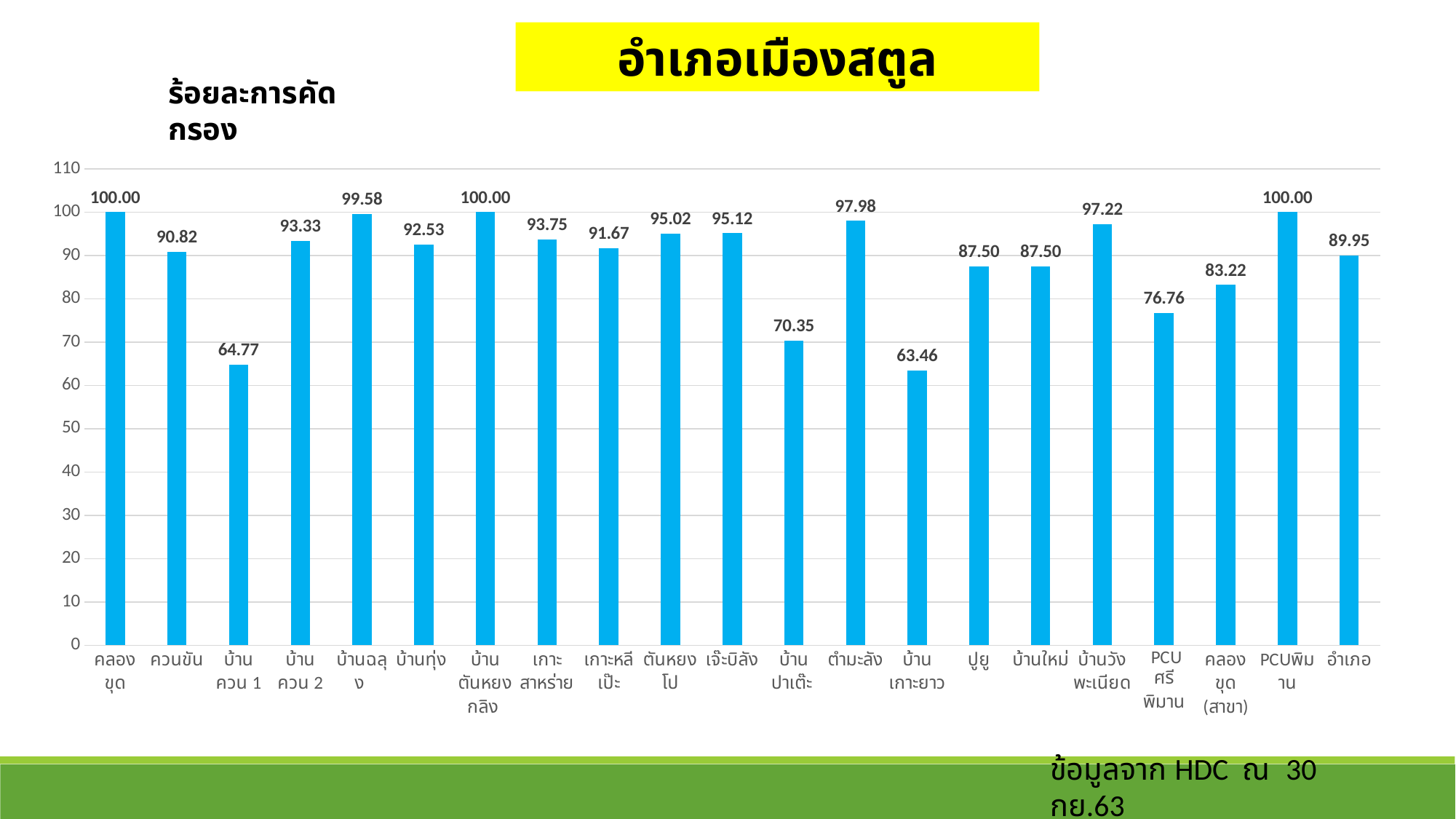
What type of chart is shown on the slide? bar chart How many categories reach a value of 100.00? 3 Is the value for บ้านปาเต๊ะ greater or less than 80? less What is the difference between the values for บ้านฉลุง and บ้านทุ่ง? 7.05 What is the value for ตำมะลัง? 97.98 Which category has the lowest value? บ้านเกาะยาว What is the title shown in the yellow box above the chart? อำเภอเมืองสตูล Which is larger, the value for เจ๊ะบิลัง or the value for ตันหยงโป? เจ๊ะบิลัง What is the value for PCUศรีพิมาน? 76.76 How many categories are plotted on the x axis? 21 What is the value for บ้านควน 1? 64.77 What is the value for อำเภอ? 89.95